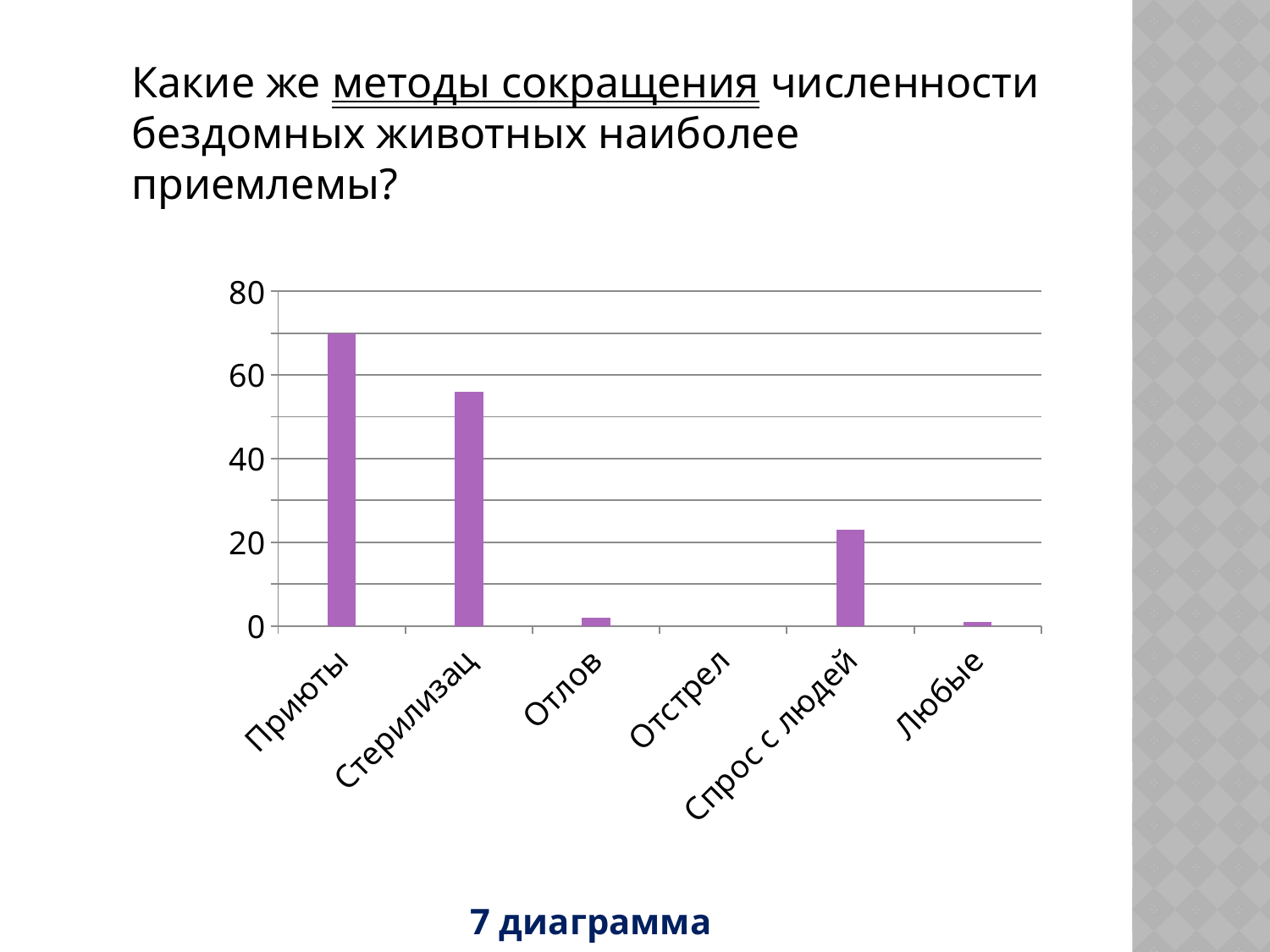
Is the value for Спрос с людей greater or less than 40? less What is the highest value shown on the vertical axis of the chart? 80 Is the value for Приюты greater or less than 60? greater What caption is written below the chart? 7 диаграмма Which category has the lowest value in the chart? Отстрел Is the value for Отлов greater or less than 20? less How many categories are shown on the x axis of the chart? 6 What kind of chart is shown on the slide? bar chart Which is larger, the value for Приюты or the value for Стерилизац? Приюты Which category has the highest bar in the chart? Приюты Which is larger, the value for Стерилизац or the value for Спрос с людей? Стерилизац